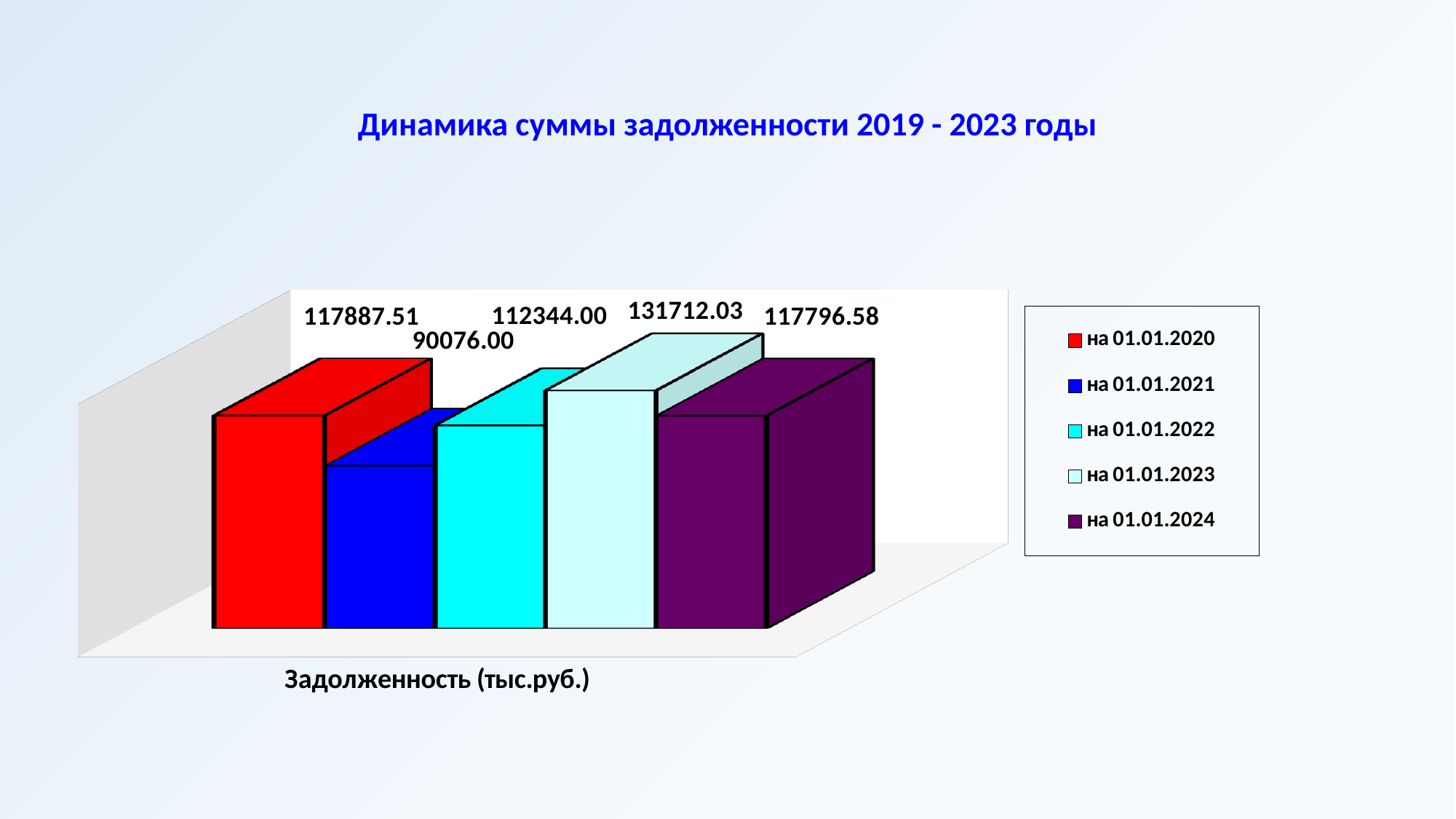
What kind of chart is shown on the slide? Bar chart How many series does the legend list? 5 What is the value for на 01.01.2020? 117887.51 What is the value for на 01.01.2024? 117796.58 What is the value for на 01.01.2023? 131712.03 Which series has the highest value? на 01.01.2023 Which is larger, the value for на 01.01.2022 or the value for на 01.01.2021? на 01.01.2022 What is the value for на 01.01.2021? 90076.00 What is the difference between the values for на 01.01.2023 and на 01.01.2021? 41636.03 What is the title of the chart? Динамика суммы задолженности 2019 - 2023 годы What is the difference between the values for на 01.01.2022 and на 01.01.2021? 22268.00 Which series has the lowest value? на 01.01.2021